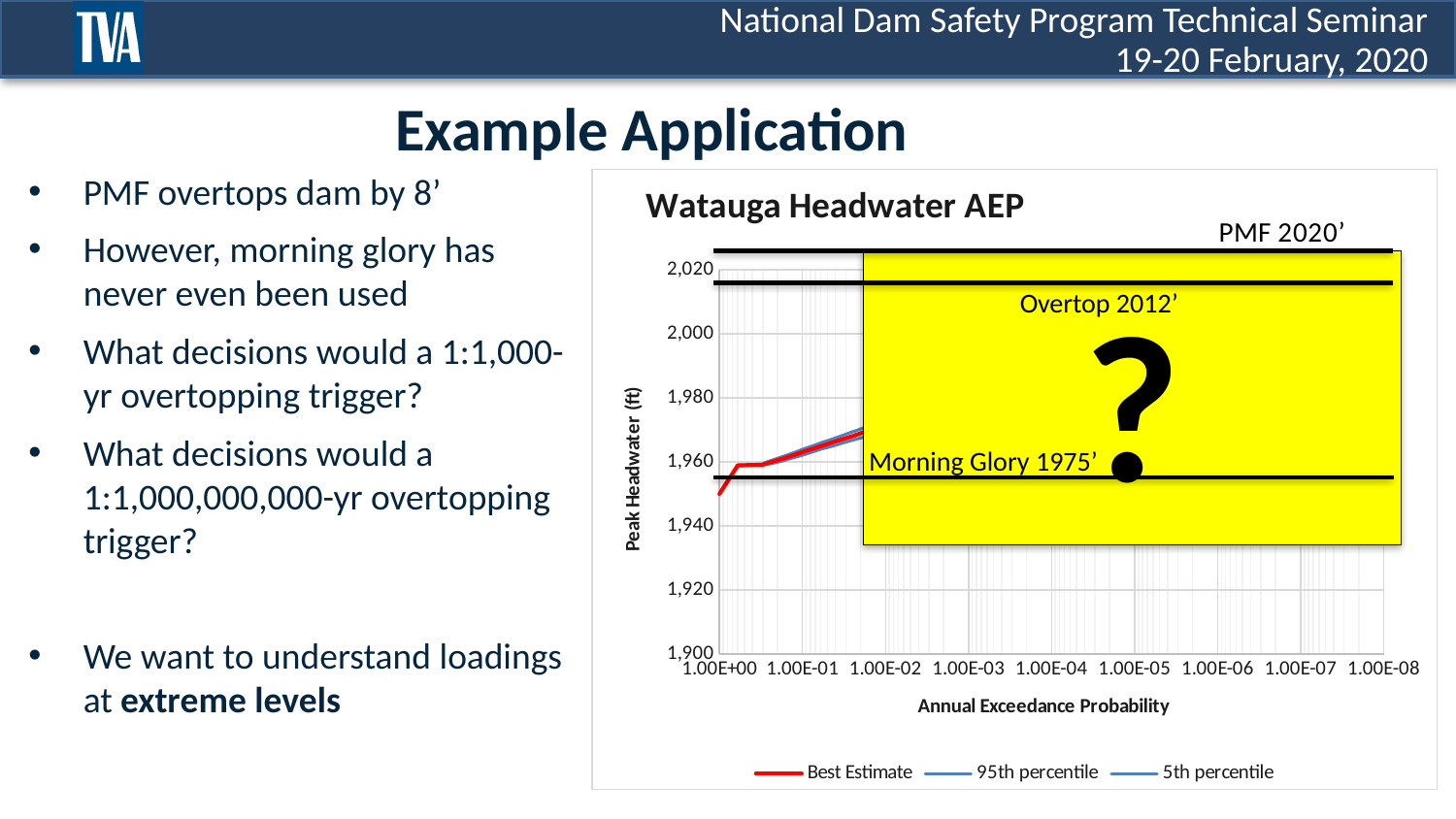
Does the Best Estimate line rise or fall as the annual exceedance probability goes from 1.00E+00 to 1.00E-02? rise How many series does the chart legend list? 3 What is the highest value labelled on the Peak Headwater (ft) axis? 2,020 What kind of chart is shown on the slide? line chart Is the Best Estimate peak headwater at an annual exceedance probability of 1.00E-01 greater or less than 1,940? greater What elevation is labelled for the PMF on the chart? 2020' What is the title of the chart? Watauga Headwater AEP Which series is drawn in red in the chart? Best Estimate What elevation is labelled for Overtop on the chart? 2012' What elevation is labelled for the Morning Glory on the chart? 1975' Is the Best Estimate peak headwater at an annual exceedance probability of 1.00E+00 greater or less than 1,960? less How many tick labels are shown on the Annual Exceedance Probability axis? 9